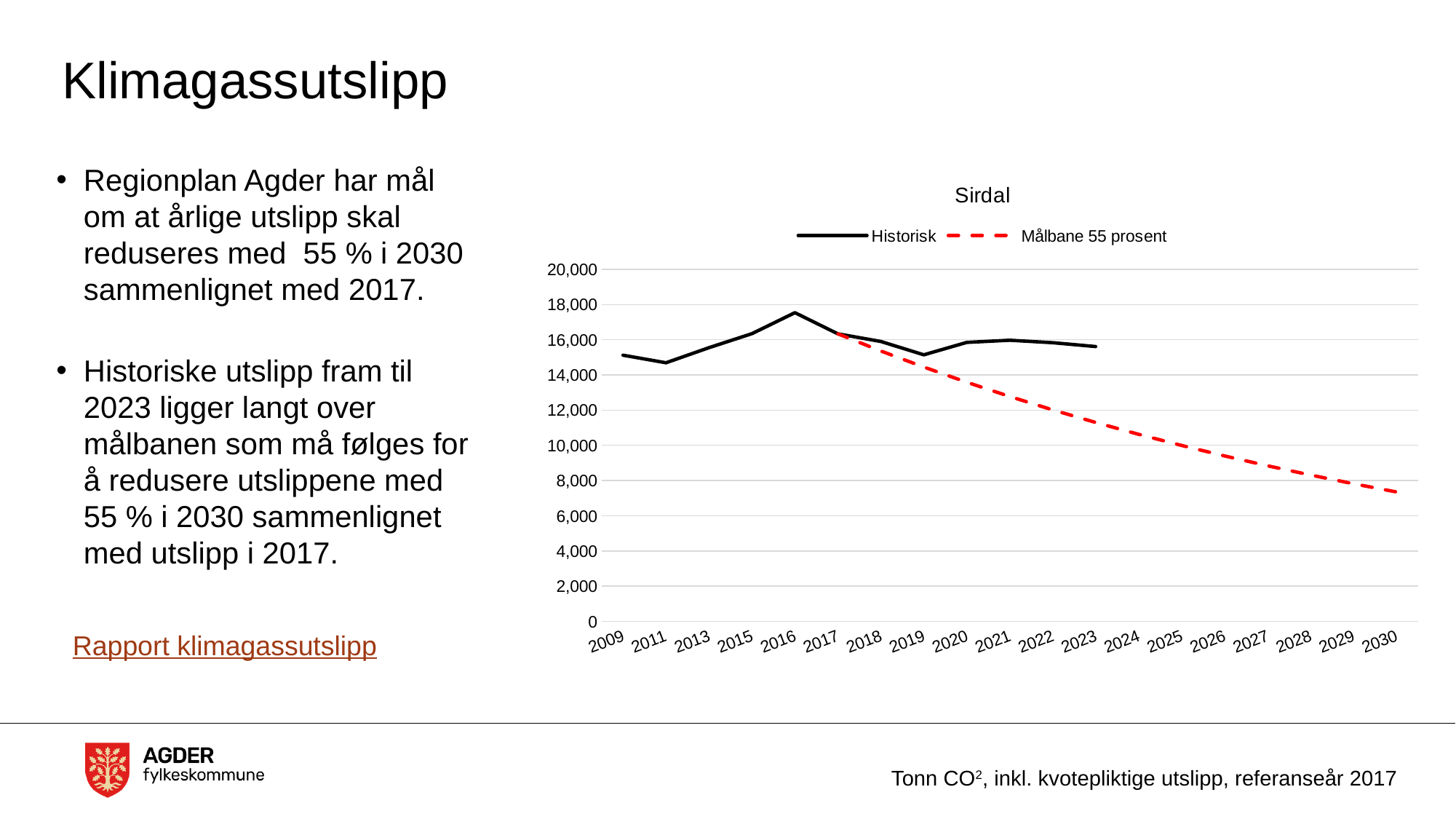
What kind of chart is shown on the slide? line chart What is the title of the chart? Sirdal Is the Historisk value for 2011 greater or less than 16,000? less Is the Målbane 55 prosent value for 2030 greater or less than 8,000? less How many series does the chart legend list? 2 Is the Målbane 55 prosent value for 2024 greater or less than 12,000? less How many years are labelled on the x axis of the chart? 19 Does the Målbane 55 prosent series rise or fall from 2017 to 2030? fall Which series is drawn as a red dashed line? Målbane 55 prosent In which year does the Historisk series reach its highest value? 2016 Which is larger for the Historisk series: the value for 2016 or the value for 2019? 2016